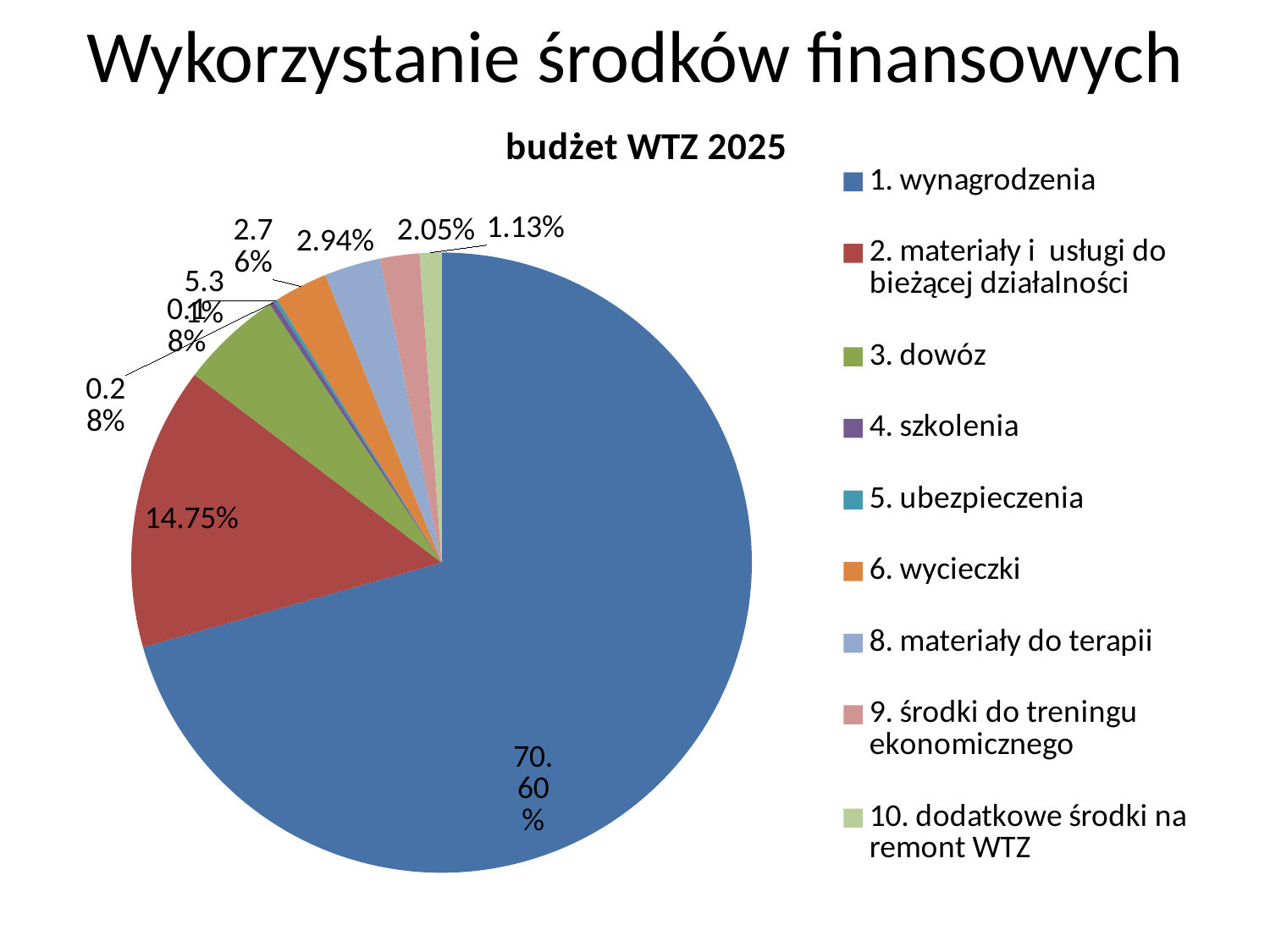
What share of the budget goes to 8. materiały do terapii? 2.94% How many categories does the legend list? 9 What share of the budget goes to 10. dodatkowe środki na remont WTZ? 1.13% What share of the budget goes to 2. materiały i usługi do bieżącej działalności? 14.75% What share of the budget goes to 1. wynagrodzenia? 70.60% Which category has the largest share of the budget? 1. wynagrodzenia Which is larger: the share for 3. dowóz or the share for 6. wycieczki? 3. dowóz What share of the budget goes to 3. dowóz? 5.31% What is the difference between the shares for 1. wynagrodzenia and 2. materiały i usługi do bieżącej działalności? 55.85% What colour is the slice for 1. wynagrodzenia? blue What is the title of the chart? budżet WTZ 2025 What kind of chart is shown on the slide? pie chart